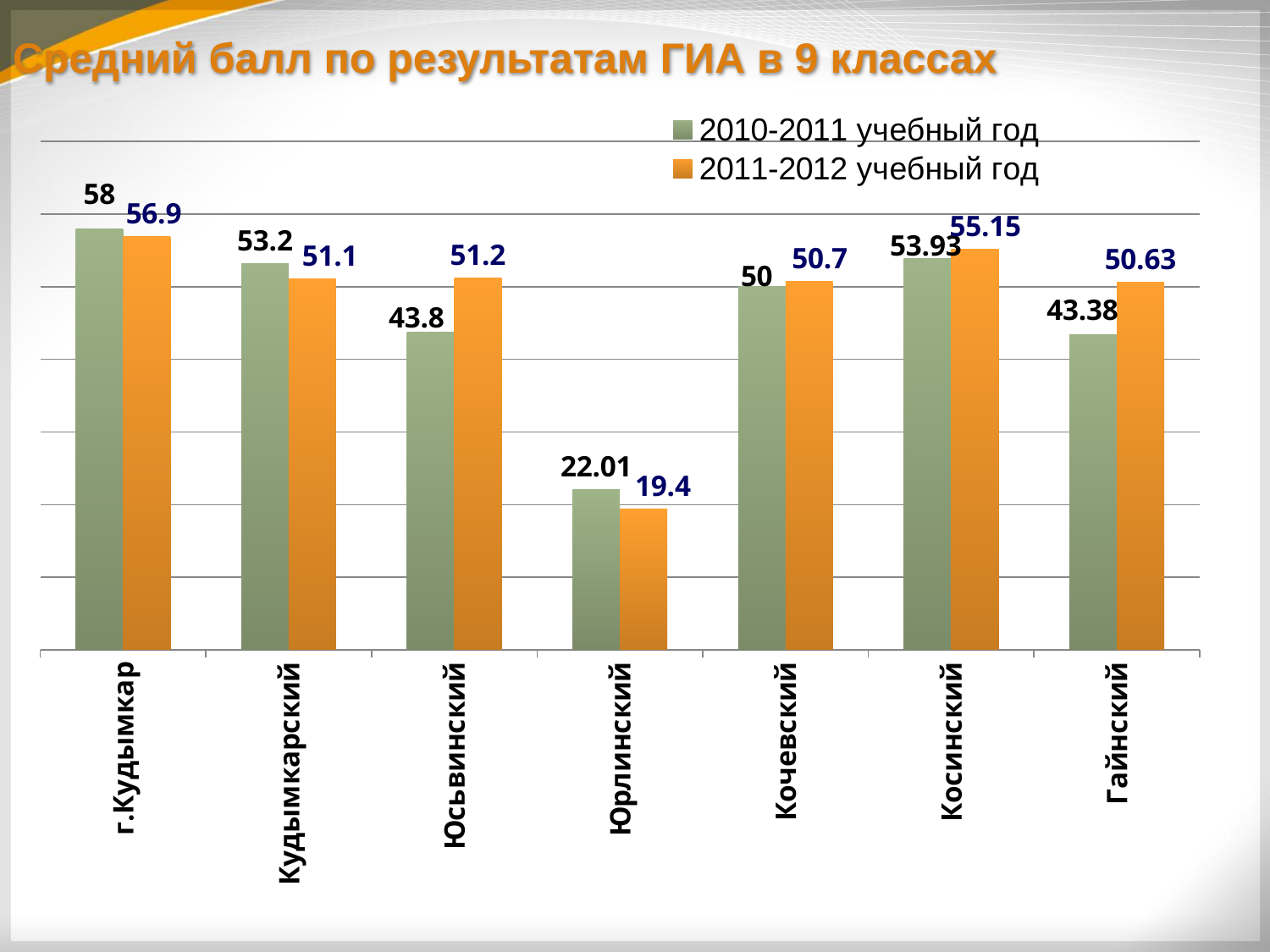
What is the value for Косинский in the 2011-2012 учебный год series? 55.15 Which is larger for Кочевский: the 2010-2011 учебный год value or the 2011-2012 учебный год value? 2011-2012 учебный год Which category has the highest value in the 2010-2011 учебный год series? г.Кудымкар How many series does the legend list? 2 What is the difference between the 2010-2011 and 2011-2012 values for Юсьвинский? 7.4 What is the value for Гайнский in the 2010-2011 учебный год series? 43.38 What is the title of the chart? Средний балл по результатам ГИА в 9 классах What is the value for Юрлинский in the 2011-2012 учебный год series? 19.4 How many categories are shown on the x axis? 7 Which category has the lowest value in the 2011-2012 учебный год series? Юрлинский What kind of chart is shown on the slide? bar chart What is the value for г.Кудымкар in the 2010-2011 учебный год series? 58